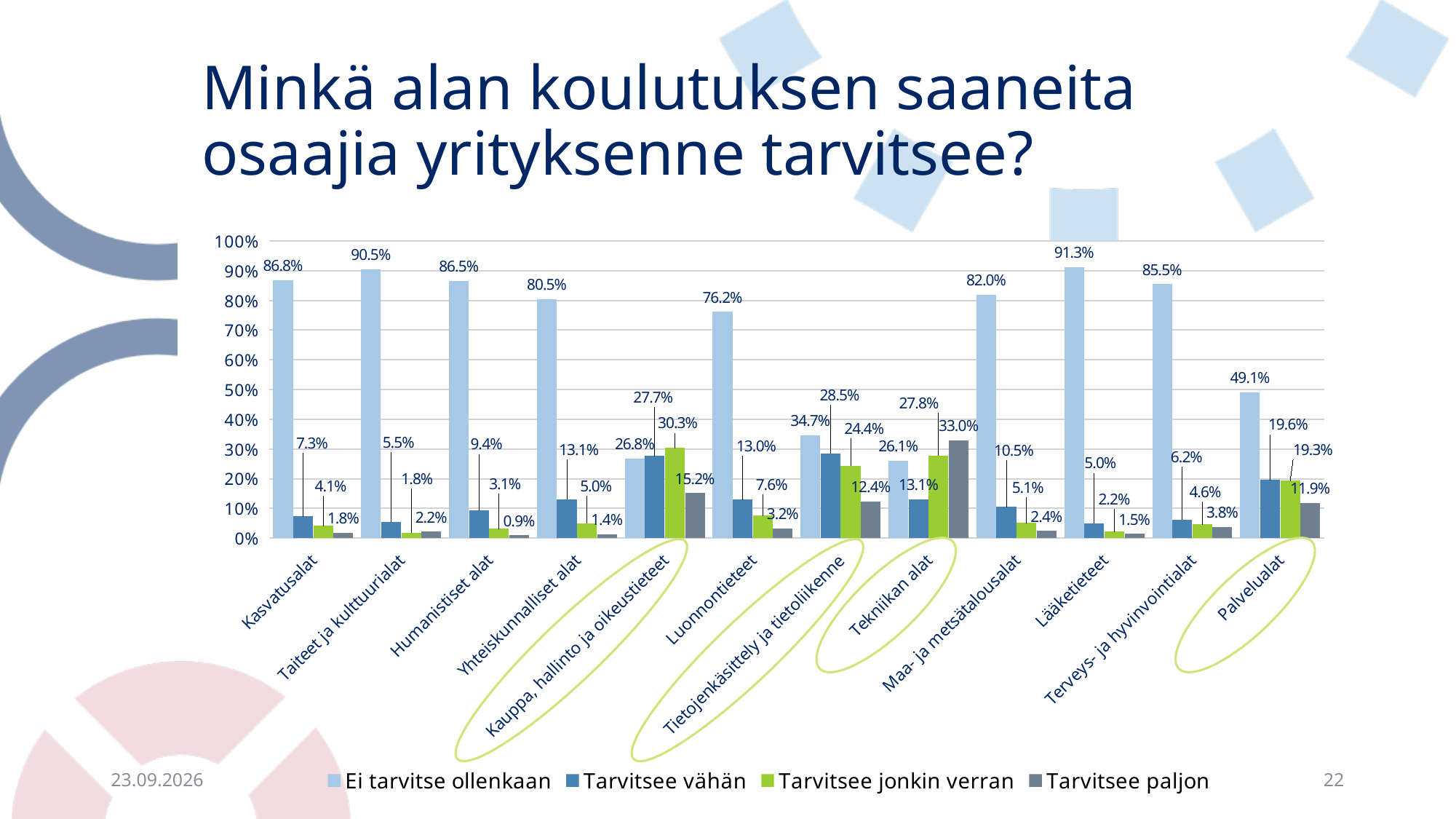
What is the value of "Ei tarvitse ollenkaan" for Lääketieteet? 91.3% What is the value of "Tarvitsee paljon" for Tekniikan alat? 33.0% How many series does the legend list? 4 What is the difference between the "Ei tarvitse ollenkaan" values for Lääketieteet and Palvelualat? 42.2% Is the "Ei tarvitse ollenkaan" value for Luonnontieteet greater or less than 70%? greater What kind of chart is shown on the slide? bar chart How many categories are shown on the x axis? 12 What is the value of "Tarvitsee vähän" for Palvelualat? 19.6% Which category has the highest value for "Ei tarvitse ollenkaan"? Lääketieteet Which is larger: "Tarvitsee paljon" for Tekniikan alat or "Tarvitsee paljon" for Tietojenkäsittely ja tietoliikenne? Tekniikan alat Which category has the lowest value for "Ei tarvitse ollenkaan"? Tekniikan alat What is the value of "Tarvitsee jonkin verran" for Kauppa, hallinto ja oikeustieteet? 30.3%